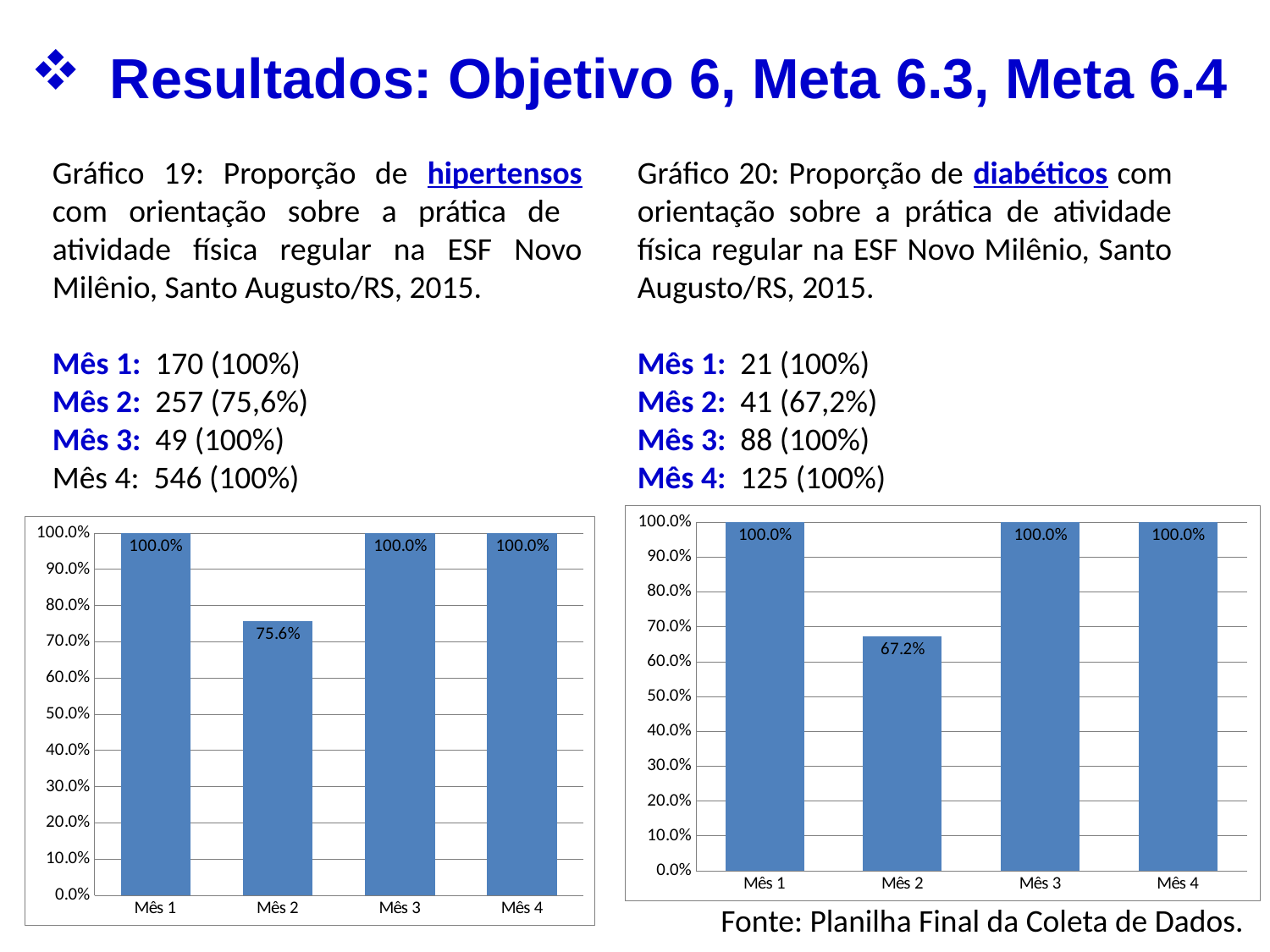
In the right chart (Gráfico 20, diabéticos), which month has the lowest value? Mês 2 In the left chart (Gráfico 19, hipertensos), which month has the lowest value? Mês 2 In the left chart (Gráfico 19, hipertensos), what is the value for Mês 3? 100.0% What kind of chart is the right chart (Gráfico 20)? Bar chart In the left chart (Gráfico 19, hipertensos), what is the difference between the values for Mês 1 and Mês 2? 24.4% How many categories (months) are shown in the left chart (Gráfico 19)? 4 In the right chart (Gráfico 20, diabéticos), what is the value for Mês 4? 100.0% In the right chart (Gráfico 20, diabéticos), what is the difference between the values for Mês 3 and Mês 2? 32.8% In the right chart (Gráfico 20, diabéticos), is the value for Mês 2 greater or less than 70.0%? less In the left chart (Gráfico 19, hipertensos), what is the value for Mês 2? 75.6% Which is larger: the Mês 2 value in the left chart (Gráfico 19) or the Mês 2 value in the right chart (Gráfico 20)? Left chart (Gráfico 19), 75.6% In the right chart (Gráfico 20, diabéticos), what is the value for Mês 2? 67.2%